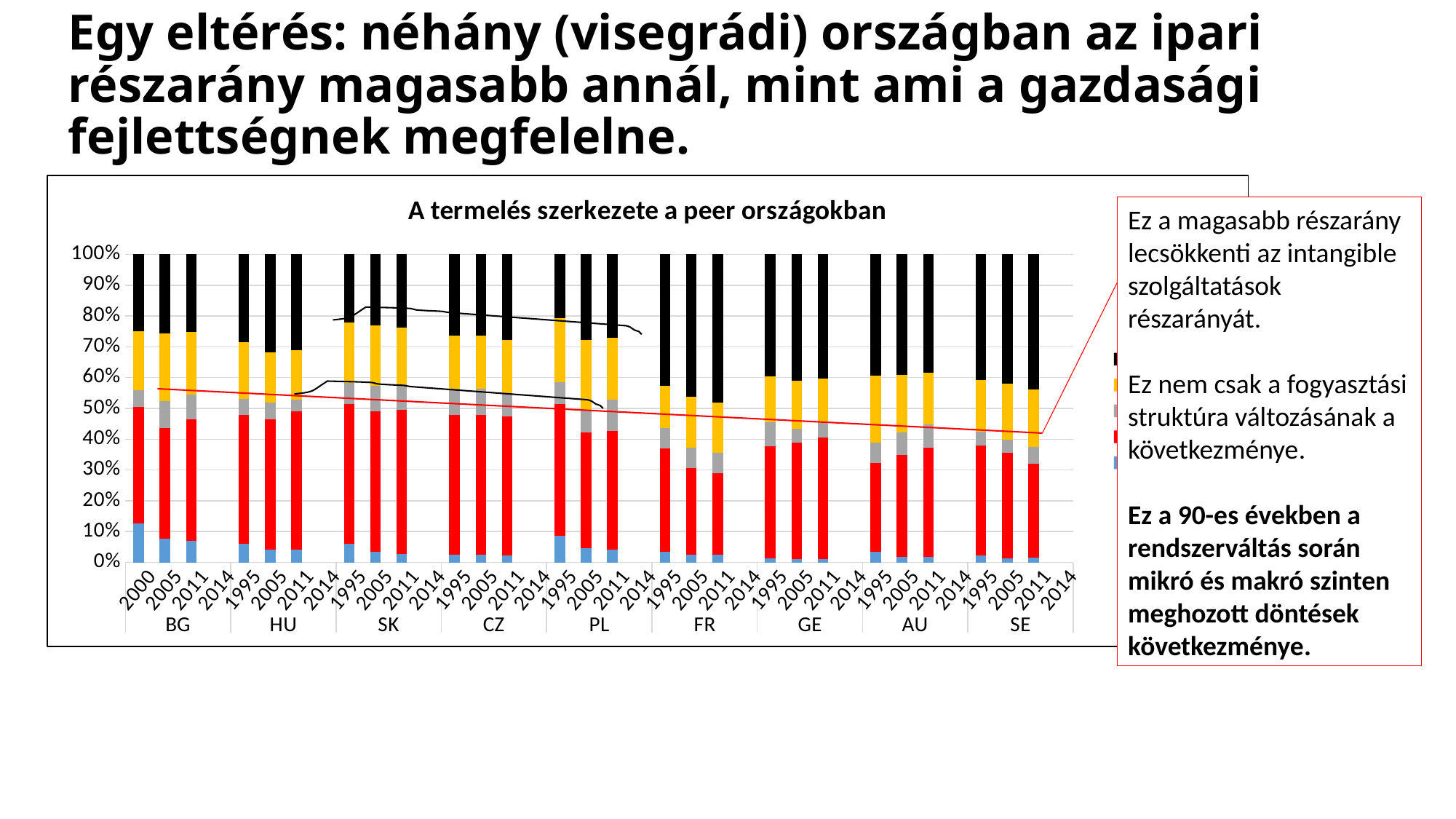
Is the top of the red segment for HU in 1995 greater or less than 40%? greater What kind of chart is shown on the slide? Stacked bar chart What is the highest value shown on the chart's vertical axis? 100% Is the top of the red segment for SE in 2011 greater or less than 40%? less What is the title of the chart on the slide? A termelés szerkezete a peer országokban Is the top of the red segment for GE in 1995 greater or less than 30%? greater How many country groups are shown along the x axis of the chart? 9 Which has the larger red segment: CZ in 1995 or FR in 1995? CZ in 1995